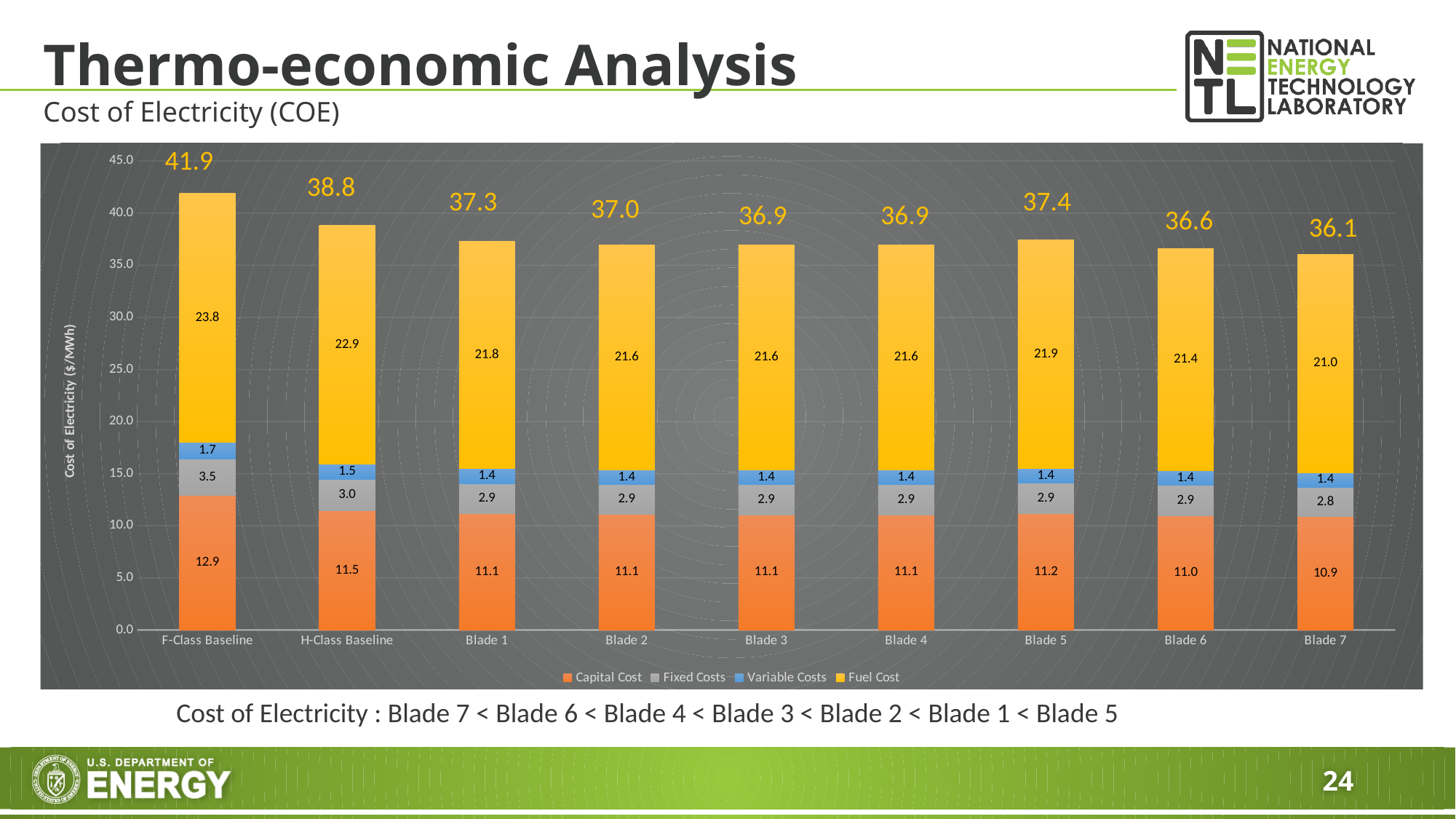
What kind of chart is shown on the slide? Stacked bar chart What is the difference between the total cost of electricity for the F-Class Baseline and the H-Class Baseline? 3.1 Which has a larger Fuel Cost, Blade 1 or Blade 6? Blade 1 What is the Capital Cost value for Blade 7? 10.9 What is the Variable Costs value for Blade 5? 1.4 What is the total cost of electricity for Blade 5? 37.4 Which category has the highest total cost of electricity? F-Class Baseline What is the Fixed Costs value for the H-Class Baseline? 3.0 How many categories are shown on the x axis? 9 What is the Fuel Cost value for the F-Class Baseline? 23.8 Which category has the lowest total cost of electricity? Blade 7 How many series does the legend list? 4